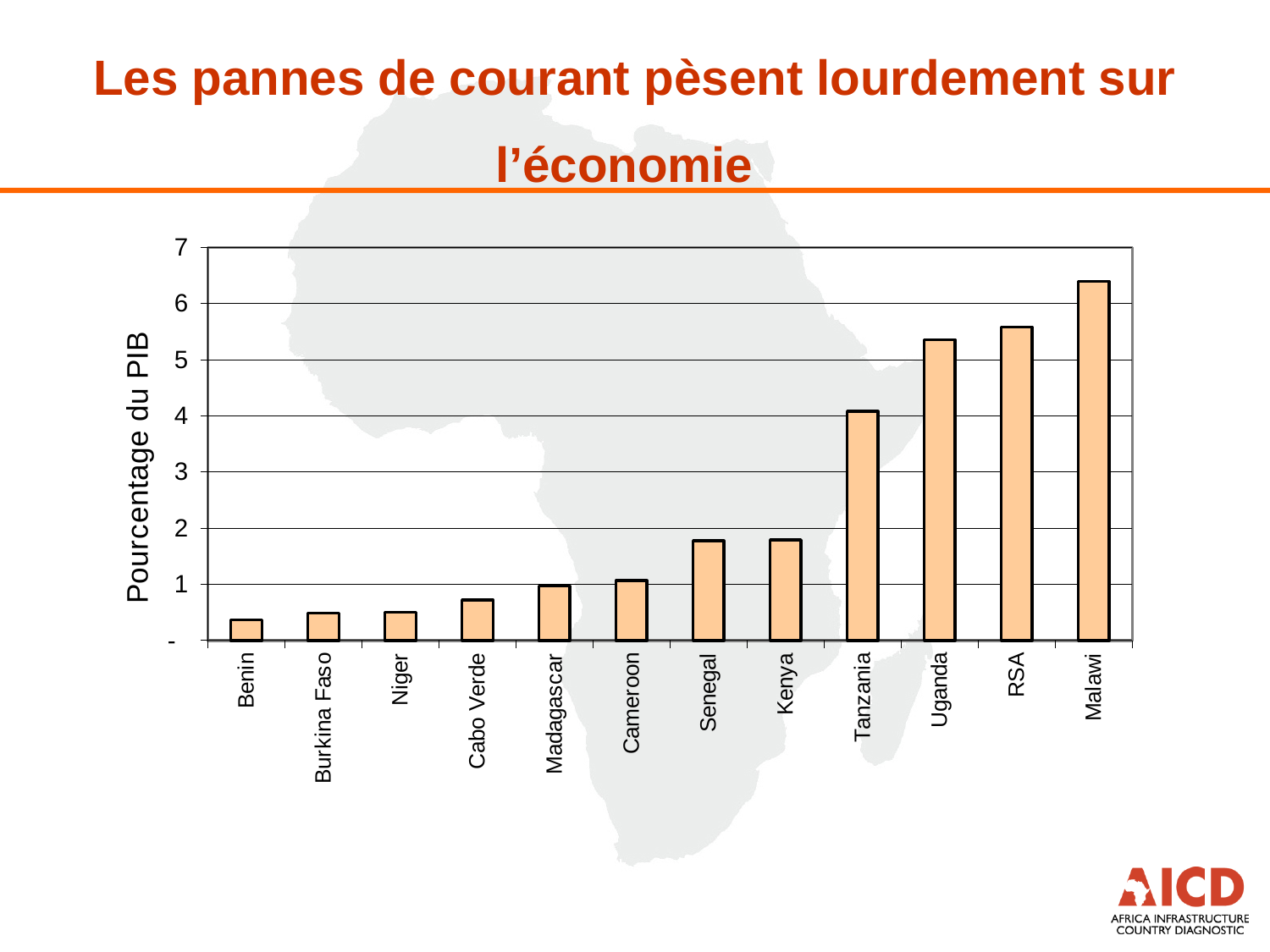
Which country has the highest value in the chart? Malawi How many countries are shown on the x axis of the chart? 12 Is the value for Senegal greater or less than 2? less Do the values generally rise or fall from left to right along the x axis? rise Is the value for Malawi greater or less than 6? greater What kind of chart is shown on the slide? bar chart Which has the larger value, Uganda or Tanzania? Uganda Is the value for Cabo Verde greater or less than 1? less What is the label on the vertical axis of the chart? Pourcentage du PIB Which has the larger value, RSA or Kenya? RSA Which country has the lowest value in the chart? Benin